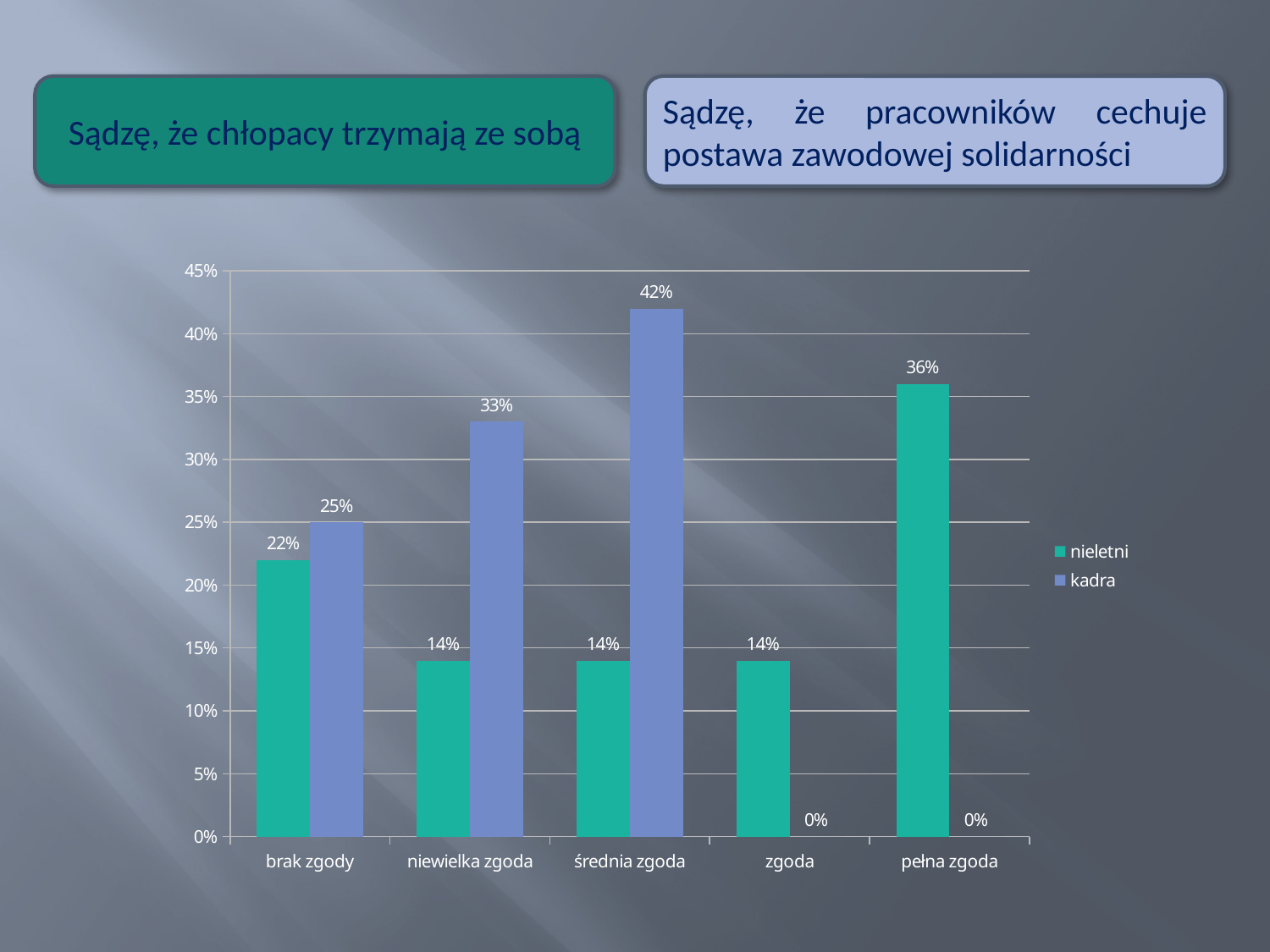
What is the value for nieletni in the pełna zgoda category? 36% What is the difference between the kadra and nieletni values in the niewielka zgoda category? 19% Which category has the highest value for the kadra series? średnia zgoda What is the value for nieletni in the brak zgody category? 22% What kind of chart is shown on the slide? bar chart What is the value for kadra in the zgoda category? 0% What is the value for kadra in the średnia zgoda category? 42% In the brak zgody category, which series has the larger value, nieletni or kadra? kadra Which category has the highest value for the nieletni series? pełna zgoda How many categories are shown on the x axis? 5 How many series does the legend list? 2 Which colour represents the kadra series? blue